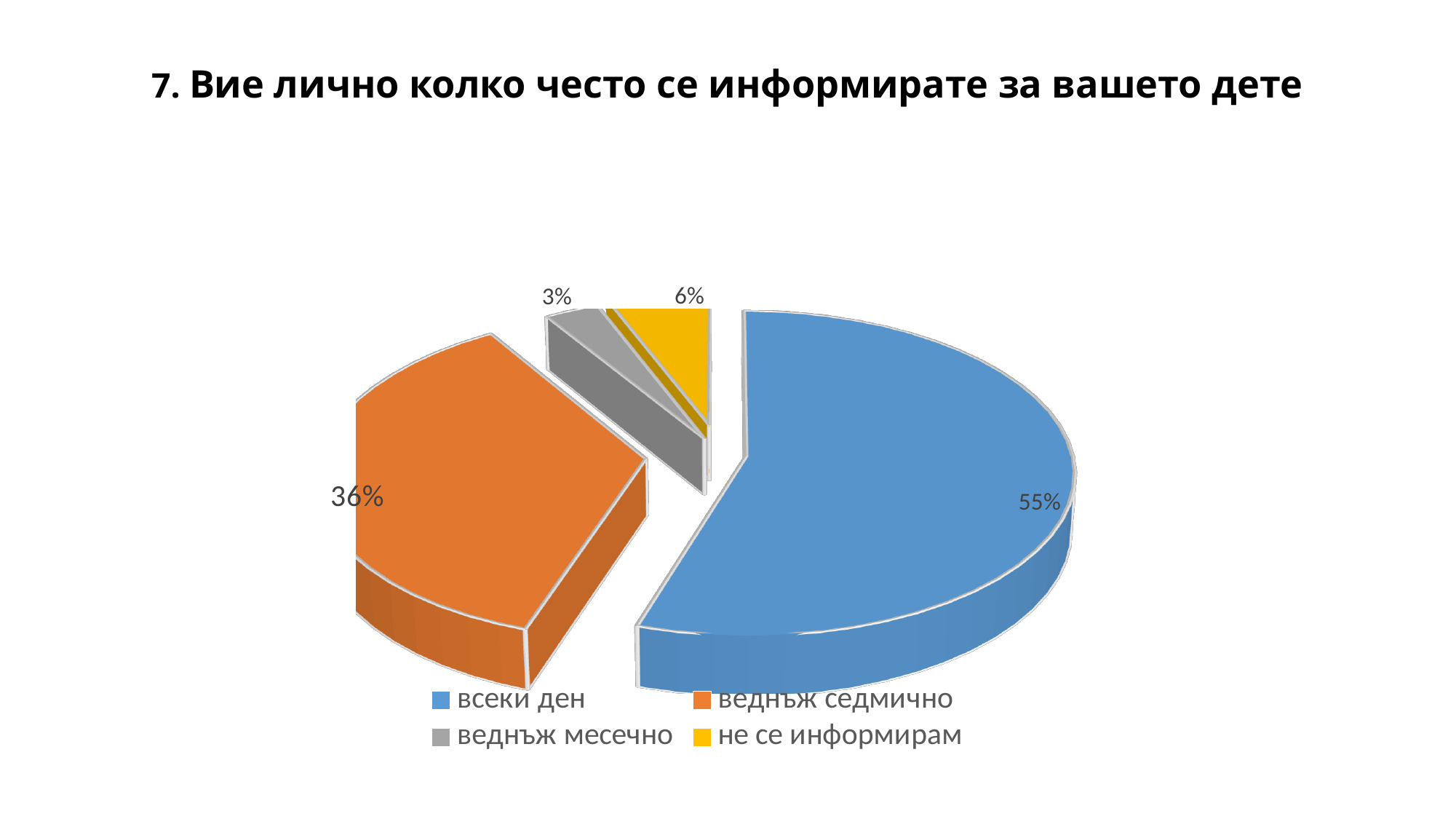
Which category has the smallest slice of the pie? веднъж месечно What is the title of the chart? 7. Вие лично колко често се информирате за вашето дете What share of the pie does "веднъж месечно" have? 3% What share of the pie does "не се информирам" have? 6% How many categories does the pie chart have? 4 Which category has the largest slice of the pie? всеки ден What kind of chart is shown on the slide? pie chart What share of the pie does "веднъж седмично" have? 36% What is the difference in percentage points between "всеки ден" and "веднъж седмично"? 19 What colour is the slice for "веднъж седмично"? orange Which is larger, the slice for "не се информирам" or the slice for "веднъж месечно"? не се информирам